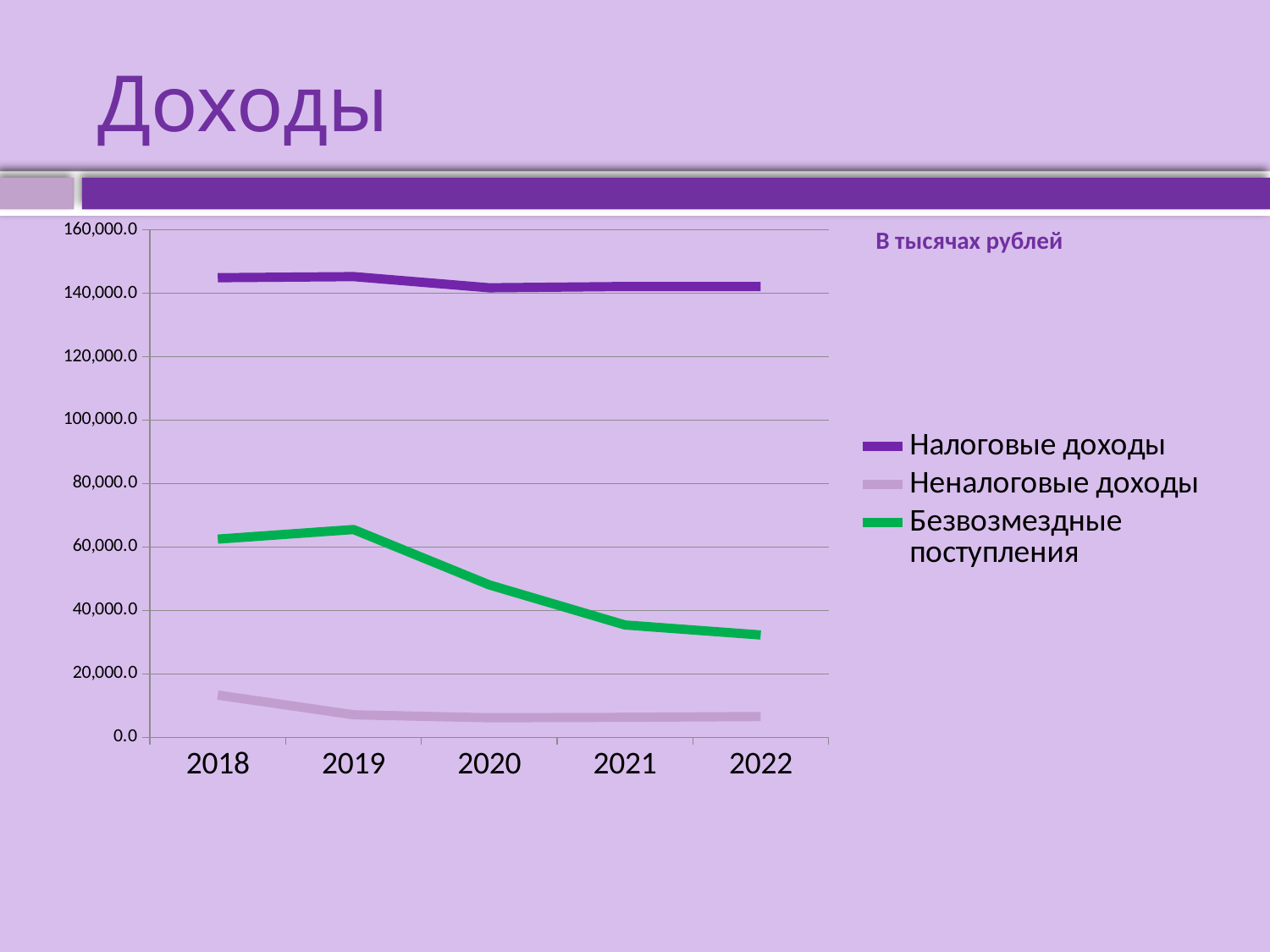
What kind of chart is shown on the slide? line chart In 2020, which is larger: Налоговые доходы or Безвозмездные поступления? Налоговые доходы Is the value for Налоговые доходы in 2018 greater or less than 140,000.0? greater How many series does the legend list? 3 Is the value for Безвозмездные поступления in 2019 greater or less than 60,000.0? greater Which series has the lowest values across all years? Неналоговые доходы In which year is Безвозмездные поступления highest? 2019 Is the value for Безвозмездные поступления in 2022 greater or less than 40,000.0? less Do the values for Безвозмездные поступления rise or fall from 2019 to 2022? fall In what units are the values given, according to the note on the slide? В тысячах рублей How many years are shown on the x axis? 5